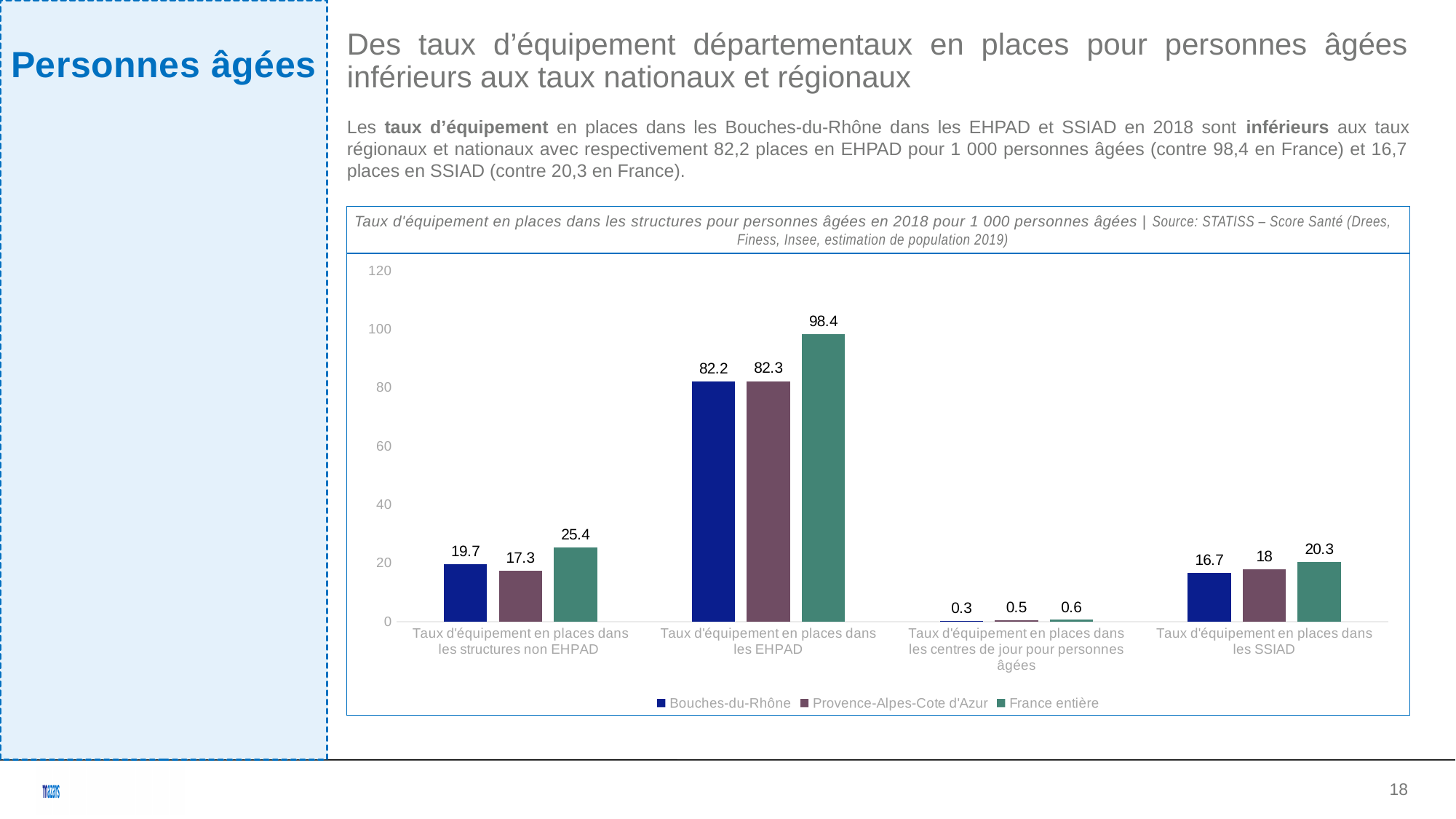
Is the value for France entière in the 'Taux d'équipement en places dans les EHPAD' category greater or less than 100? less Which is larger in the 'Taux d'équipement en places dans les structures non EHPAD' category: Bouches-du-Rhône or France entière? France entière What is the difference between the France entière and Bouches-du-Rhône values in the 'Taux d'équipement en places dans les EHPAD' category? 16.2 What kind of chart is shown on the slide? Bar chart What is the value for Provence-Alpes-Cote d'Azur in the 'Taux d'équipement en places dans les structures non EHPAD' category? 17.3 How many series does the legend list? 3 What is the value for Bouches-du-Rhône in the 'Taux d'équipement en places dans les centres de jour pour personnes âgées' category? 0.3 Which category has the lowest values across all three series? Taux d'équipement en places dans les centres de jour pour personnes âgées How many categories are shown on the x axis? 4 What is the value for Bouches-du-Rhône in the 'Taux d'équipement en places dans les EHPAD' category? 82.2 Which series has the highest value in the 'Taux d'équipement en places dans les EHPAD' category? France entière What is the value for France entière in the 'Taux d'équipement en places dans les SSIAD' category? 20.3